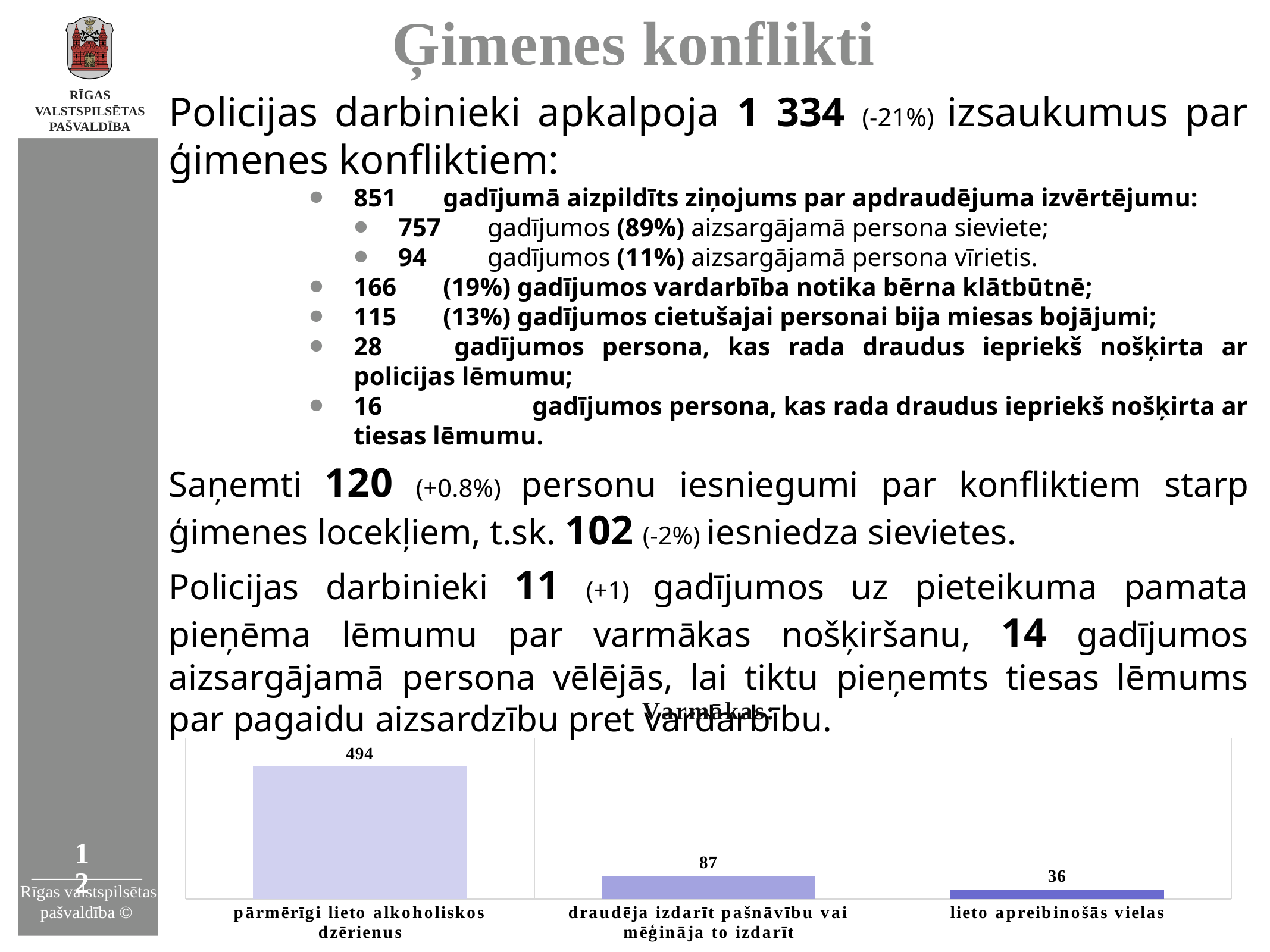
What is the difference between the values for "pārmērīgi lieto alkoholiskos dzērienus" and "draudēja izdarīt pašnāvību vai mēģināja to izdarīt"? 407 What value is shown for "draudēja izdarīt pašnāvību vai mēģināja to izdarīt" in the chart? 87 Which category has the lowest value in the chart? lieto apreibinošās vielas Do the values in the chart rise or fall from left to right? fall Which category has the highest value in the chart? pārmērīgi lieto alkoholiskos dzērienus What value is shown for "lieto apreibinošās vielas" in the chart? 36 What is the title of the chart at the bottom of the slide? Varmākas: What value is shown for "pārmērīgi lieto alkoholiskos dzērienus" in the chart? 494 Which is larger: the value for "draudēja izdarīt pašnāvību vai mēģināja to izdarīt" or for "lieto apreibinošās vielas"? draudēja izdarīt pašnāvību vai mēģināja to izdarīt How many categories are shown in the chart? 3 What is the difference between the values for "draudēja izdarīt pašnāvību vai mēģināja to izdarīt" and "lieto apreibinošās vielas"? 51 What kind of chart is shown at the bottom of the slide? bar chart